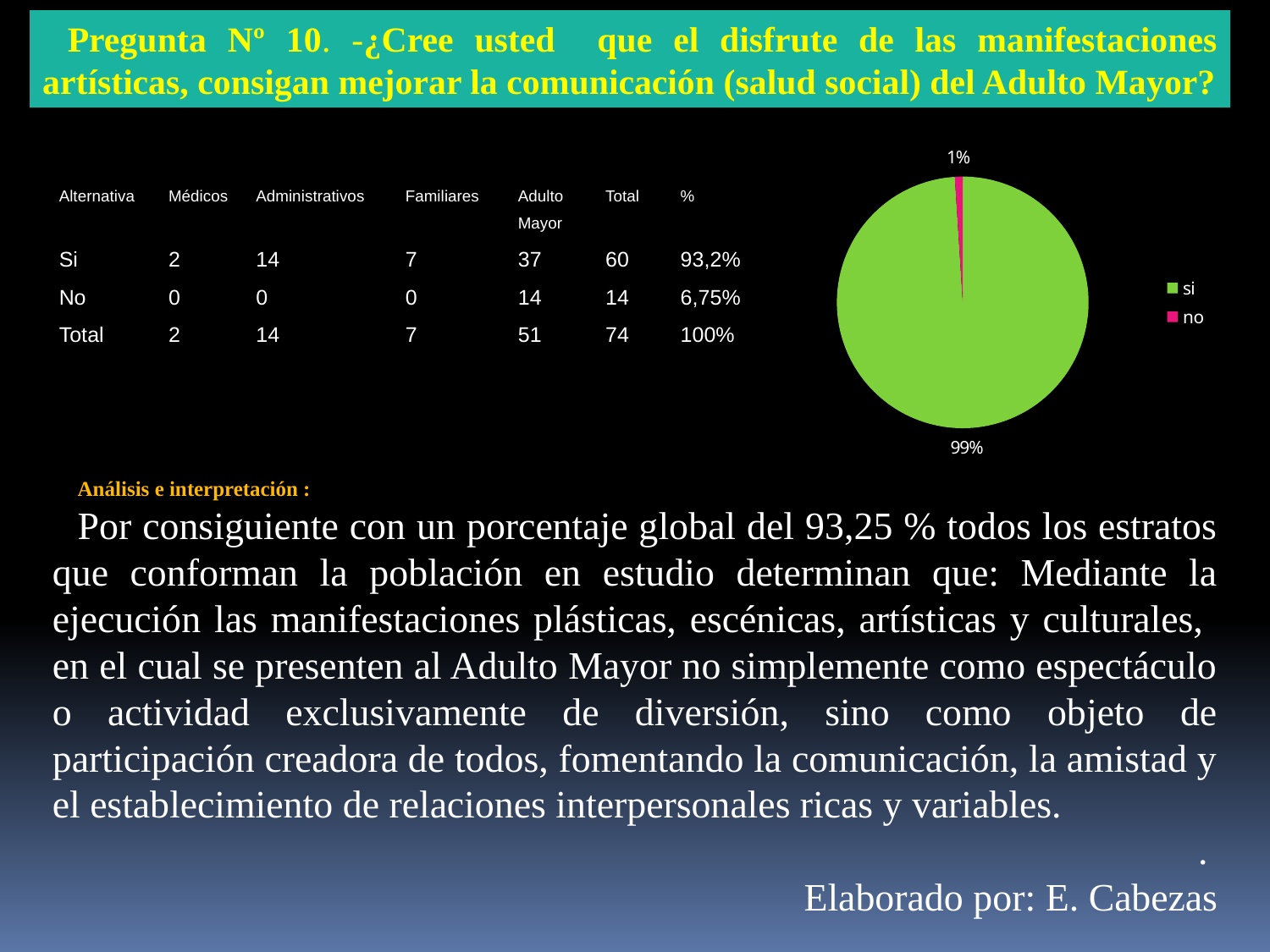
Which slice of the pie chart is the largest? si What kind of chart is shown on the slide? pie chart What colour is the "no" slice in the pie chart? pink What share of the pie does the "si" slice represent? 99% What is the difference in percentage points between the "si" and "no" slices of the pie chart? 98 What colour is the "si" slice in the pie chart? green How many entries does the pie chart's legend list? 2 What percentage does the pie chart show for "si"? 99% What percentage does the pie chart show for "no"? 1% Which is larger in the pie chart, the "si" slice or the "no" slice? si Which slice of the pie chart is the smallest? no How many slices does the pie chart have? 2